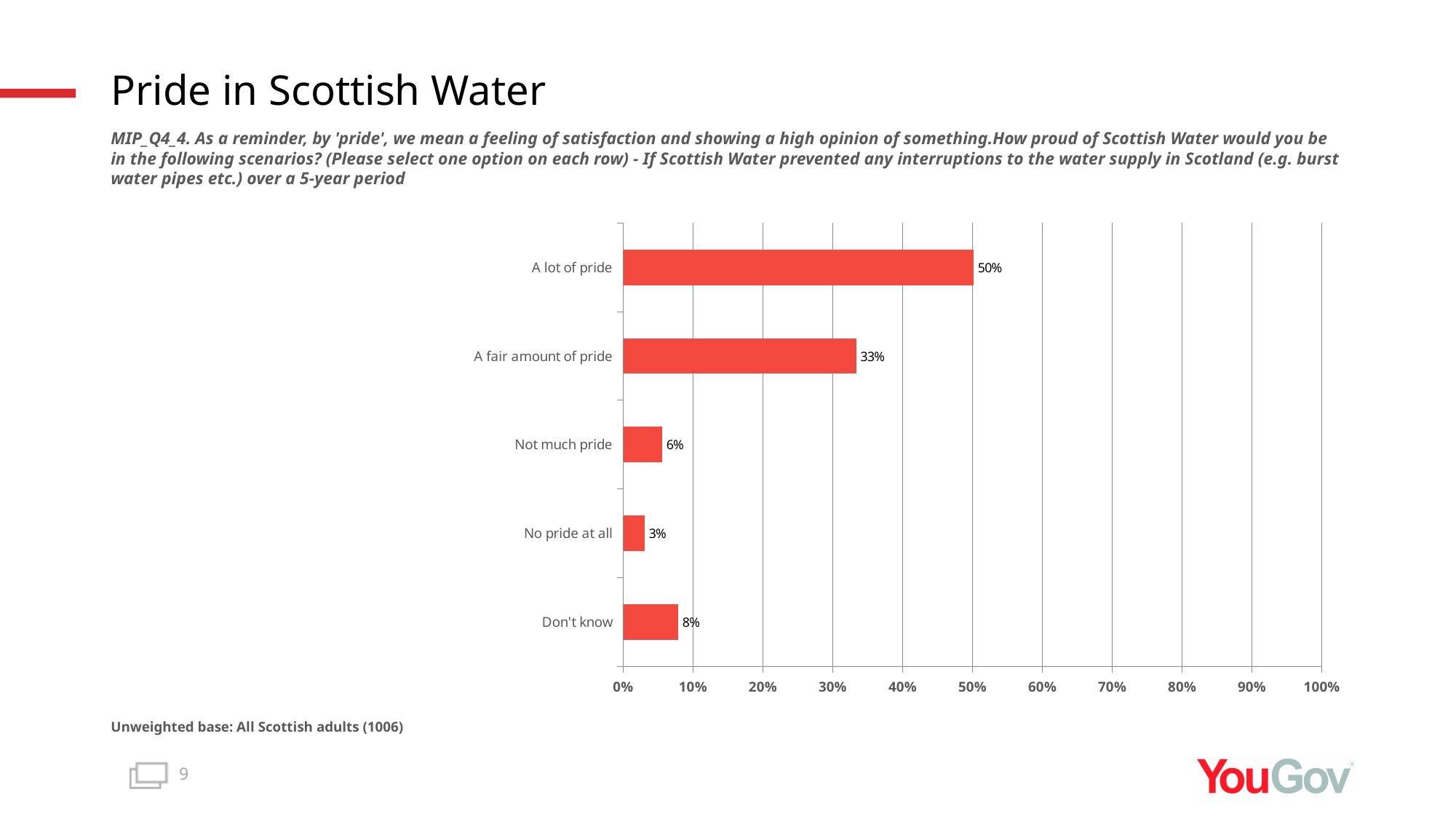
Which category has the highest value? A lot of pride Which is larger: 'Not much pride' or 'Don't know'? Don't know Is the value for 'A fair amount of pride' greater or less than 40%? less What percentage of respondents said they would feel 'A lot of pride'? 50% What percentage answered 'Don't know'? 8% What kind of chart is shown on the slide? Bar chart What is the value for 'A fair amount of pride'? 33% How many categories are shown on the chart? 5 What is the unweighted base stated below the chart? All Scottish adults (1006) What is the difference between 'A lot of pride' and 'A fair amount of pride'? 17 percentage points Which category has the lowest value? No pride at all What is the combined value of 'Not much pride' and 'No pride at all'? 9%